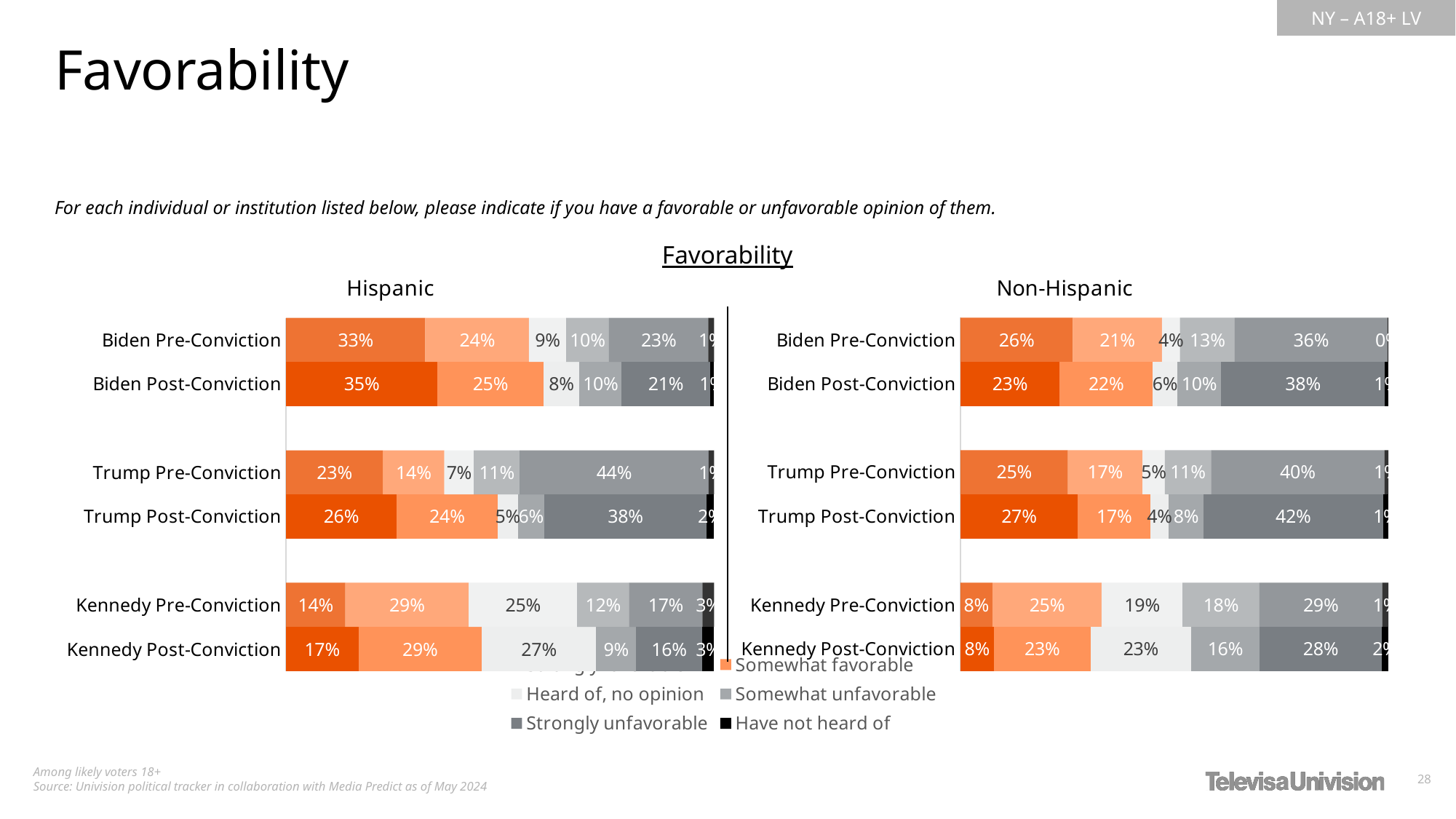
In the Non-Hispanic chart, what is the Heard of, no opinion value for Biden Pre-Conviction? 4% In the Hispanic chart, what is the Somewhat favorable value for Biden Post-Conviction? 25% How many categories (bars) are shown in the Hispanic chart? 6 In the Hispanic chart, which category has the lowest Strongly unfavorable value? Kennedy Post-Conviction What type of chart is used to show the favorability data? Stacked bar chart In the Non-Hispanic chart, how much higher is the Strongly unfavorable value for Biden Post-Conviction than for Biden Pre-Conviction? 2 percentage points In the Hispanic chart, what is the Strongly unfavorable value for Trump Pre-Conviction? 44% In the Non-Hispanic chart, which category has the highest Strongly unfavorable value? Trump Post-Conviction In the Hispanic chart, how much higher is the Strongly unfavorable value for Trump Pre-Conviction than for Trump Post-Conviction? 6 percentage points In the Hispanic chart, what is the Heard of, no opinion value for Kennedy Post-Conviction? 27% In the Non-Hispanic chart, which has the larger Somewhat unfavorable value: Kennedy Pre-Conviction or Biden Post-Conviction? Kennedy Pre-Conviction In the Non-Hispanic chart, what is the Somewhat favorable value for Kennedy Pre-Conviction? 25%